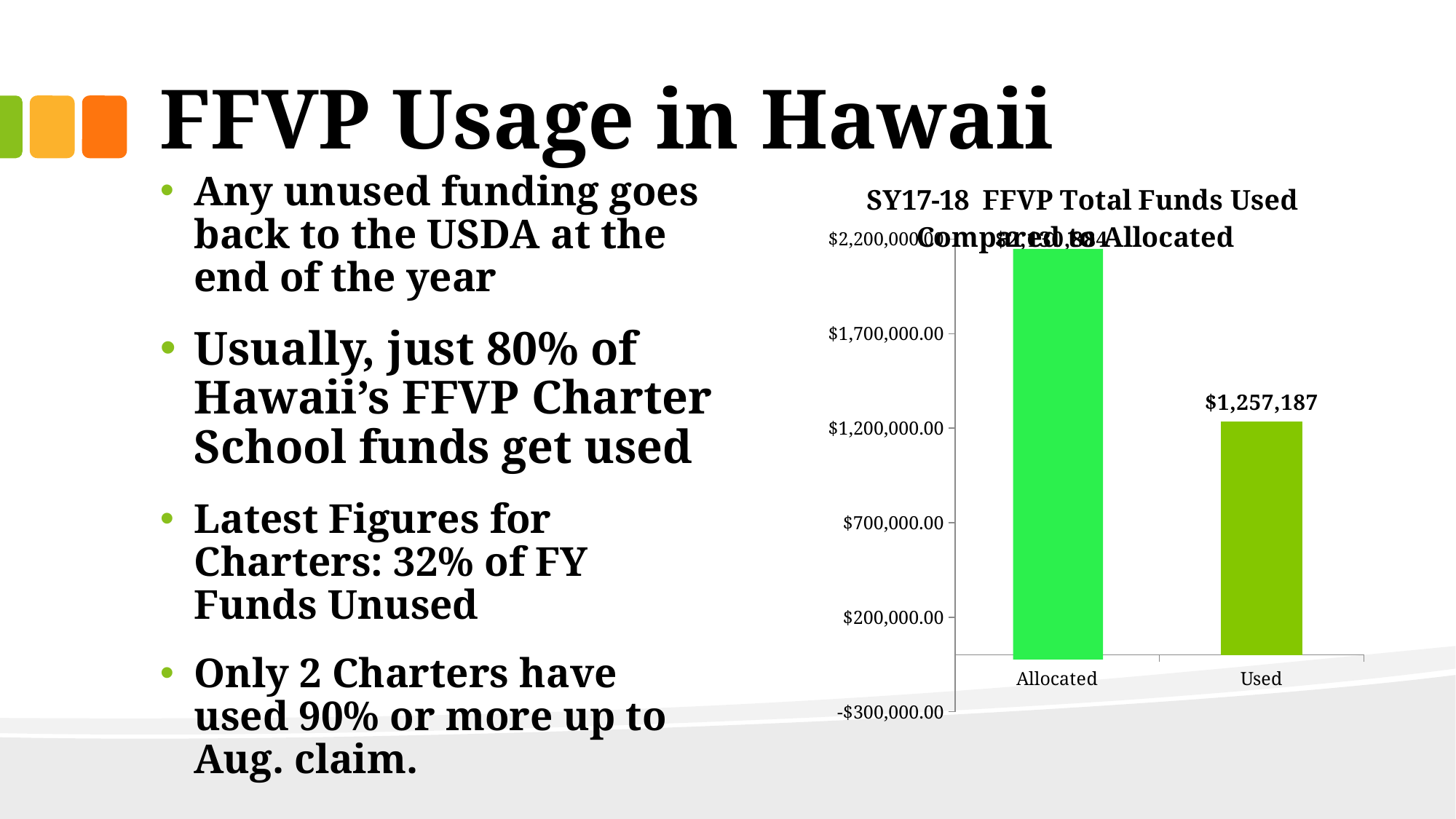
Is the value for Used greater or less than $1,700,000.00? less What kind of chart is shown on the slide? Bar chart Is the value for Allocated greater or less than $1,700,000.00? greater Do the values rise or fall from Allocated to Used along the x axis? Fall Which is larger, the value for Allocated or the value for Used? Allocated How many categories are shown on the x axis of the chart? 2 Which category has the highest value in the chart? Allocated What is the title of the chart? SY17-18 FFVP Total Funds Used Compared to Allocated Which category has the lowest value in the chart? Used What is the lowest value shown on the chart's y axis? -$300,000.00 Is the value for Used greater or less than $700,000.00? greater What is the value for Used in the chart? $1,257,187